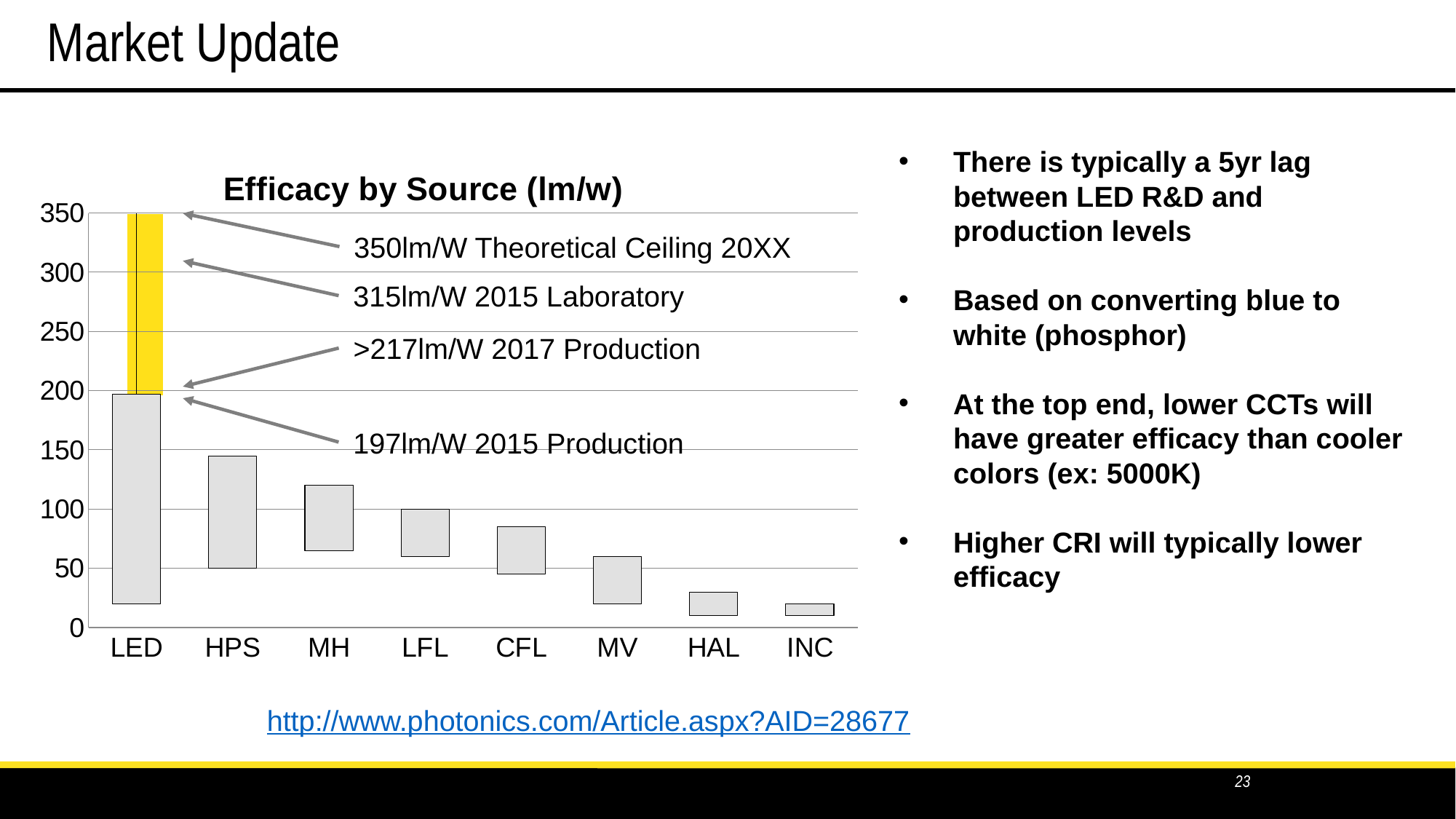
Which has a higher maximum efficacy in the chart, HPS or MH? HPS How many light source categories are shown on the x axis of the chart? 8 Is the top of the HPS bar greater or less than 100? greater According to the chart annotation, what is the theoretical ceiling for LED efficacy? 350lm/W What is the title of the chart? Efficacy by Source (lm/w) Which light source has the highest efficacy in the chart? LED According to the chart annotation, what was the LED efficacy for 2015 production? 197lm/W According to the chart annotation, what was the LED efficacy achieved in the laboratory in 2015? 315lm/W What kind of chart is shown on the slide? bar chart What is the difference between the 350lm/W theoretical ceiling and the 315lm/W 2015 laboratory value shown on the chart? 35lm/W Which light source has the lowest efficacy in the chart? INC Is the top of the HAL bar greater or less than 50? less